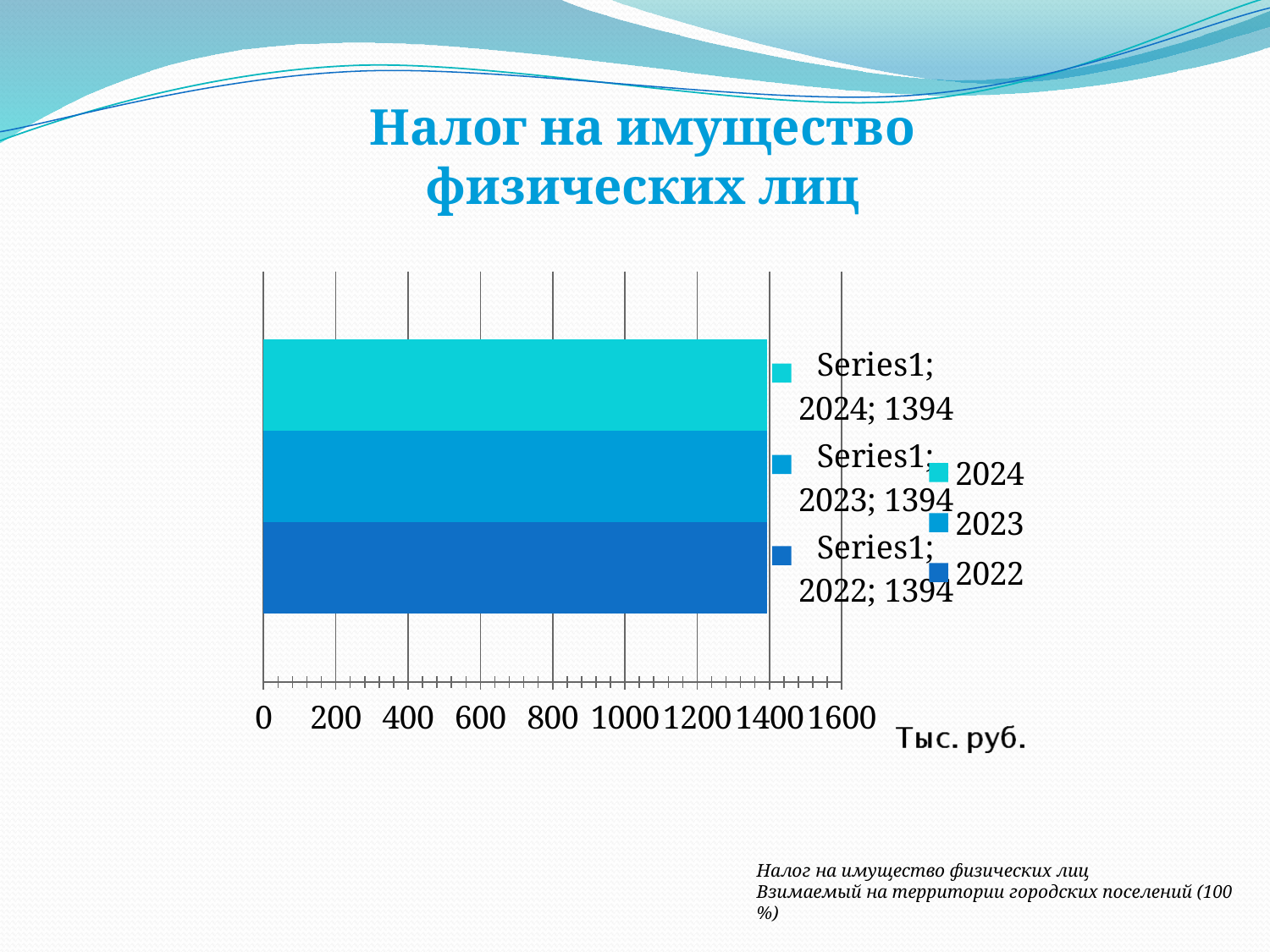
What is the value for 2024? 1394 What kind of chart is shown on the slide? bar chart Is the value for 2022 greater or less than 1600? less What is the difference between the values for 2024 and 2022? 0 What is the value for 2022? 1394 What is the title of the chart? Налог на имущество физических лиц How many entries does the legend list? 3 Do the values change from 2022 to 2024? No, they stay the same What is the value for 2023? 1394 What unit is shown on the horizontal axis? Тыс. руб. Is the value for 2023 greater or less than 1200? greater How many bars are plotted in the chart? 3